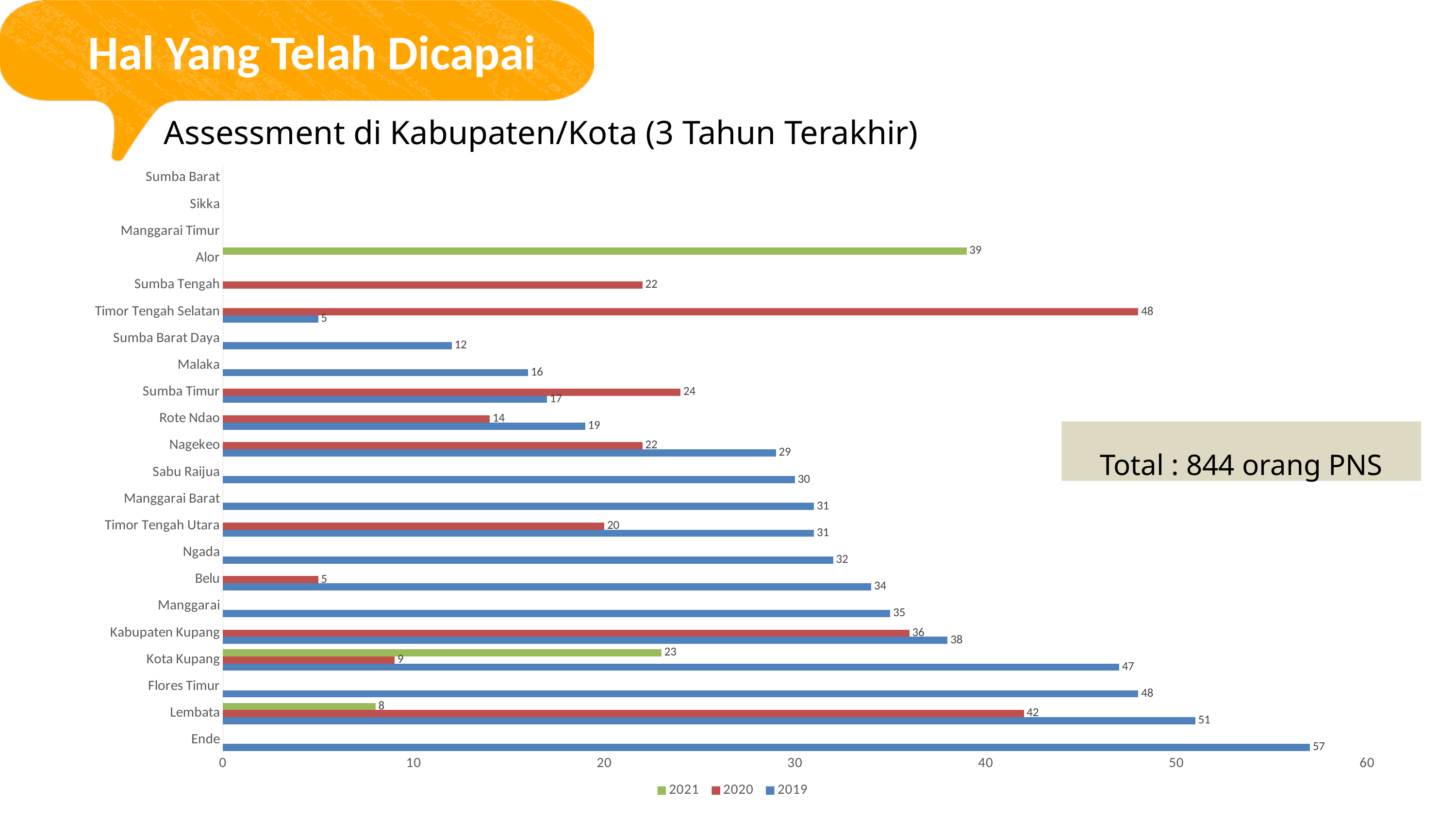
What is the total of the three series for Kota Kupang? 79 What is the 2019 value for Ende? 57 How many series does the legend list? 3 What is the 2021 value for Alor? 39 What is the title of the chart? Assessment di Kabupaten/Kota (3 Tahun Terakhir) Which category has the lowest 2021 value among those with a 2021 bar? Lembata Which category has the highest 2019 value? Ende What is the 2020 value for Timor Tengah Selatan? 48 Which is larger for Kota Kupang, the 2019 value or the 2021 value? 2019 What kind of chart is shown on the slide? Bar chart How many categories are listed on the vertical axis? 22 What is the difference between the 2019 and 2020 values for Lembata? 9